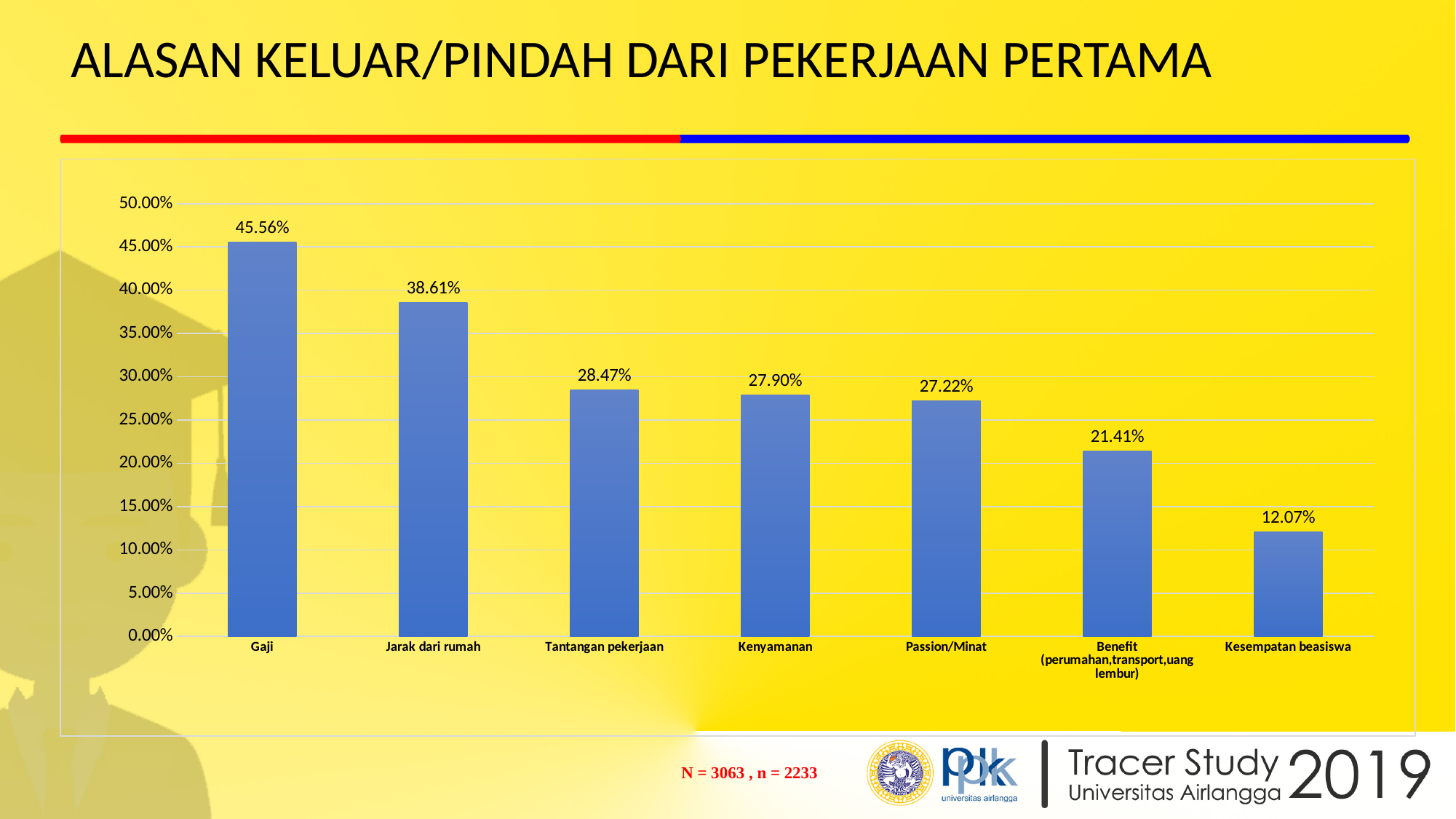
What is the difference between the values for Gaji and Jarak dari rumah? 6.95% Which category has the highest value? Gaji Is the value for Kenyamanan greater or less than 25.00%? greater What is the value for Kesempatan beasiswa? 12.07% Which is larger, the value for Tantangan pekerjaan or the value for Benefit (perumahan,transport,uang lembur)? Tantangan pekerjaan What is the value for Gaji? 45.56% Which category has the lowest value? Kesempatan beasiswa What is the value for Benefit (perumahan,transport,uang lembur)? 21.41% What is the value for Jarak dari rumah? 38.61% What kind of chart is shown on the slide? bar chart Do the values rise or fall from left to right along the x axis? fall How many categories are shown on the x axis? 7